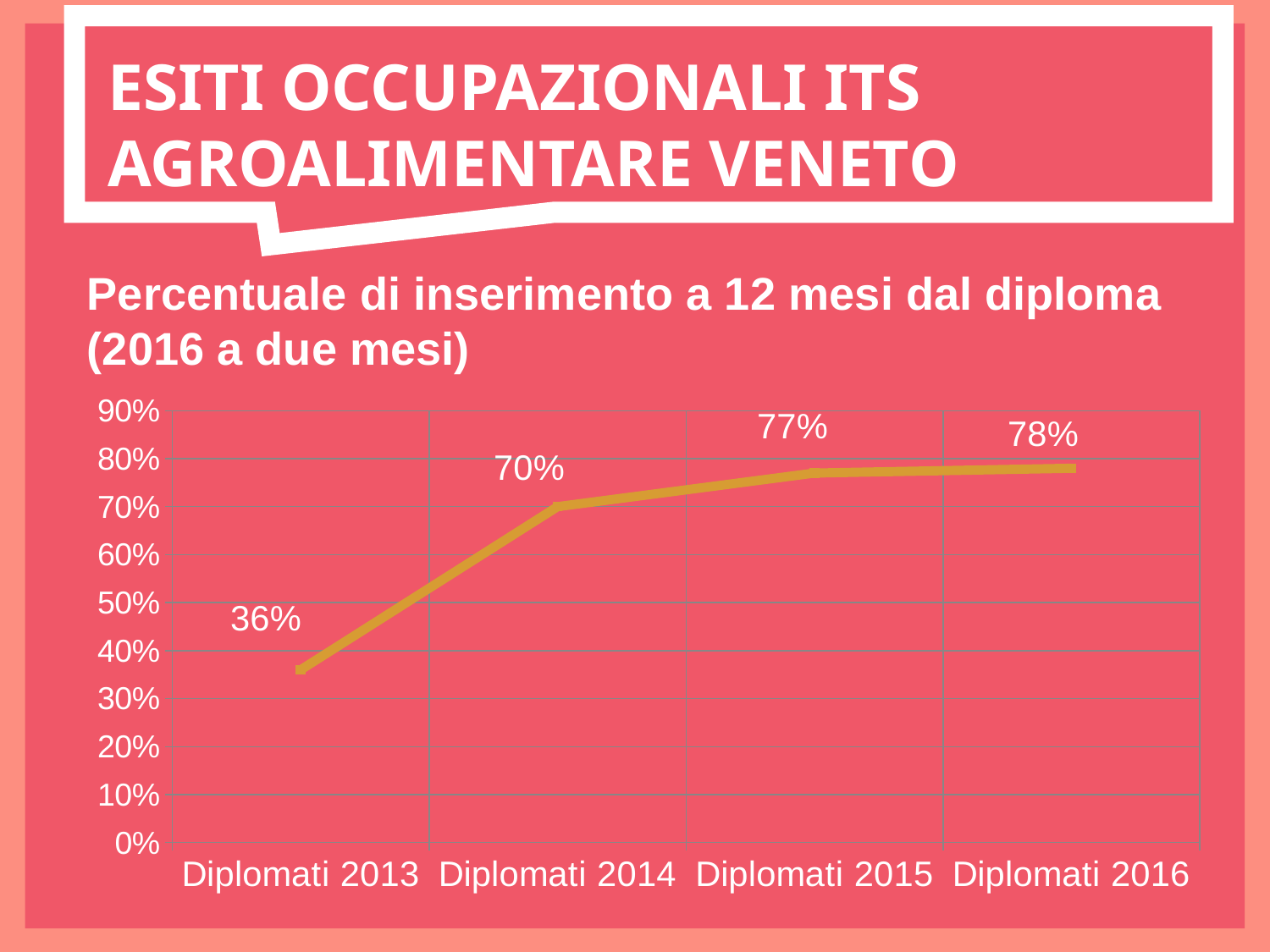
Which is larger, the value for Diplomati 2014 or the value for Diplomati 2013? Diplomati 2014 What is the value for Diplomati 2014? 70% Which category has the highest value? Diplomati 2016 What kind of chart is shown on the slide? Line chart Which category has the lowest value? Diplomati 2013 What is the value for Diplomati 2016? 78% Do the values rise or fall from Diplomati 2013 to Diplomati 2016? Rise What is the difference between the values for Diplomati 2014 and Diplomati 2013? 34% What is the value for Diplomati 2013? 36% What is the value for Diplomati 2015? 77% What is the difference between the values for Diplomati 2016 and Diplomati 2015? 1% How many categories are plotted on the x axis? 4